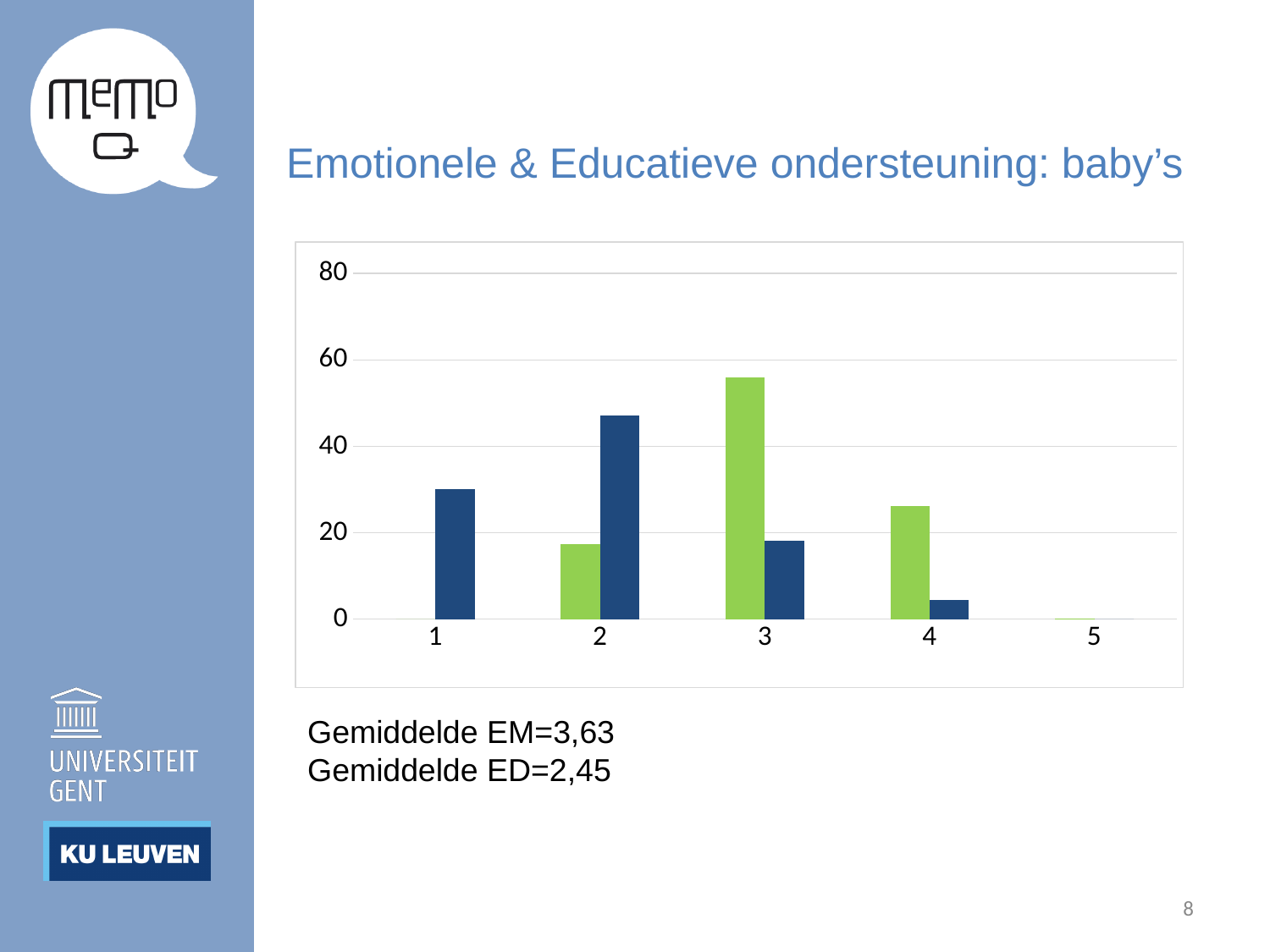
What is the title of the slide containing the chart? Emotionele & Educatieve ondersteuning: baby's What kind of chart is shown on the slide? bar chart Is the value of the green bar for category 3 greater or less than 40? greater For category 2, which bar is larger, the green one or the blue one? blue Is the value of the blue bar for category 4 greater or less than 20? less How many categories are shown on the x axis of the chart? 5 Is the value of the green bar for category 4 greater or less than 20? greater For which category is the green bar the highest? 3 For which category is the blue bar the highest? 2 For category 3, which bar is larger, the green one or the blue one? green